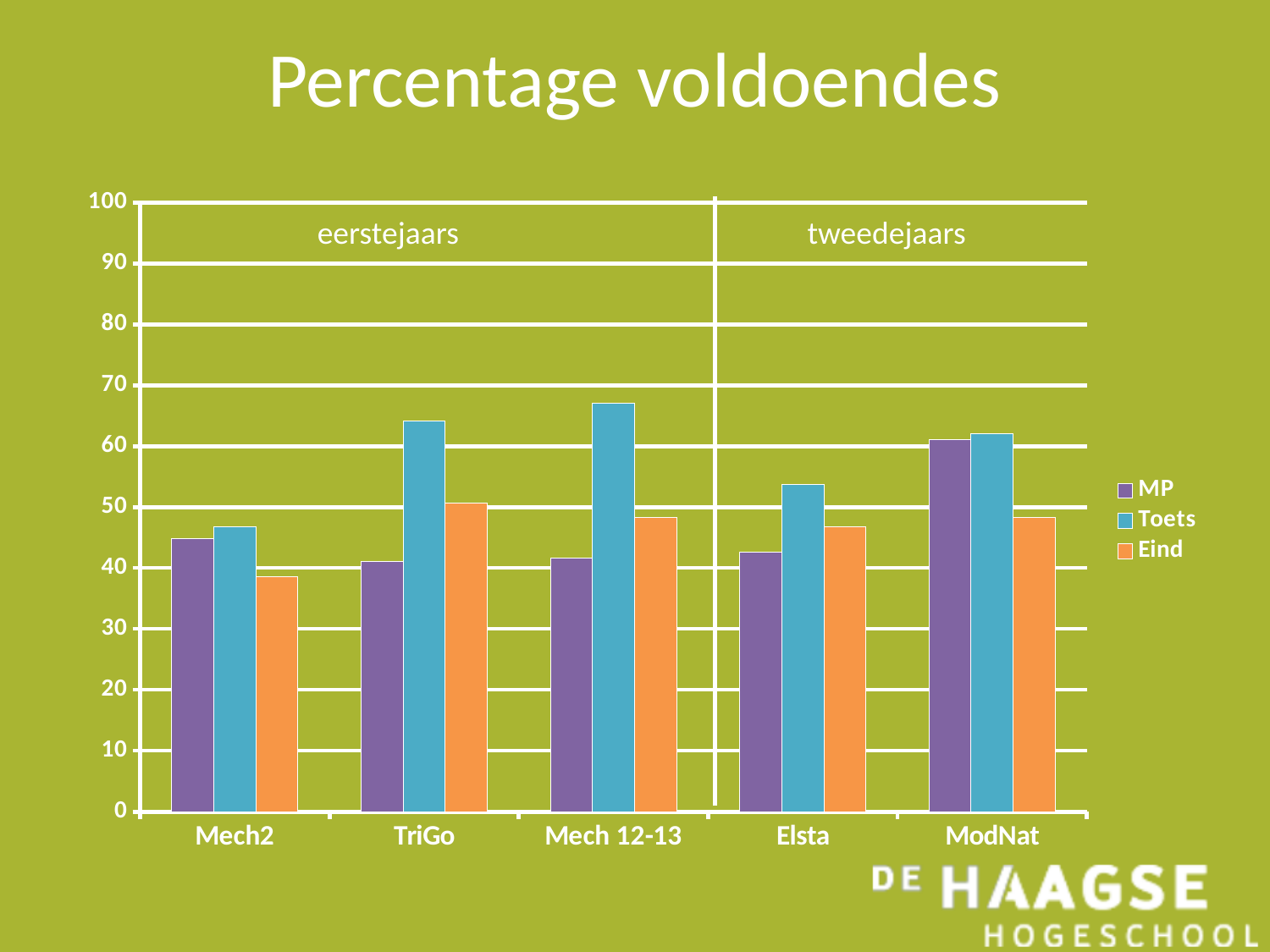
Is the MP value for ModNat greater or less than 50? greater Which category has the lowest Eind value? Mech2 What kind of chart is shown on the slide? bar chart How many categories are shown on the x axis? 5 Which category has the highest Toets value? Mech 12-13 For TriGo, which is larger: the MP value or the Toets value? Toets What is the title of the chart? Percentage voldoendes Which categories fall under the 'tweedejaars' group? Elsta and ModNat Is the Toets value for TriGo greater or less than 60? greater Which category has the highest MP value? ModNat Is the Eind value for Mech2 greater or less than 40? less How many series does the legend list? 3